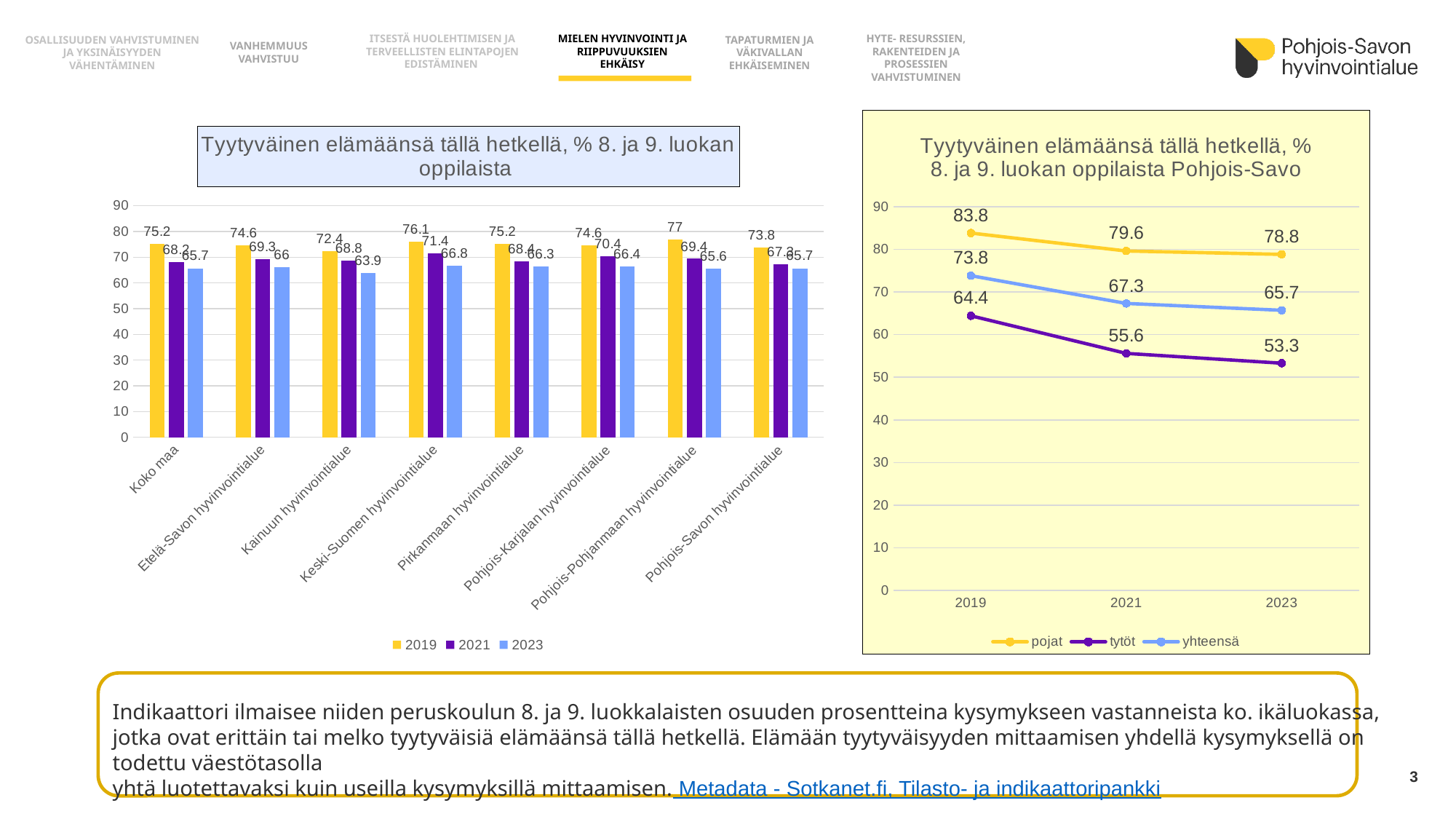
What kind of chart is the chart on the right? Line chart In the right chart (Pohjois-Savo), what is the value for tytöt in 2021? 55.6 In the right chart (Pohjois-Savo), do the values for pojat rise or fall from 2019 to 2023? Fall In the left chart, how many series does the legend list? 3 What kind of chart is the chart on the left? Bar chart In the left chart, which category has the highest 2019 value? Pohjois-Pohjanmaan hyvinvointialue In the left chart, what is the 2019 value for Pohjois-Pohjanmaan hyvinvointialue? 77 In the right chart (Pohjois-Savo), what is the difference between pojat and tytöt in 2023? 25.5 In the left chart, what is the 2023 value for Kainuun hyvinvointialue? 63.9 In the left chart, how many categories are shown on the x axis? 8 In the left chart, which category has the lowest 2023 value? Kainuun hyvinvointialue In the left chart, what is the difference between the 2019 and 2023 values for Koko maa? 9.5